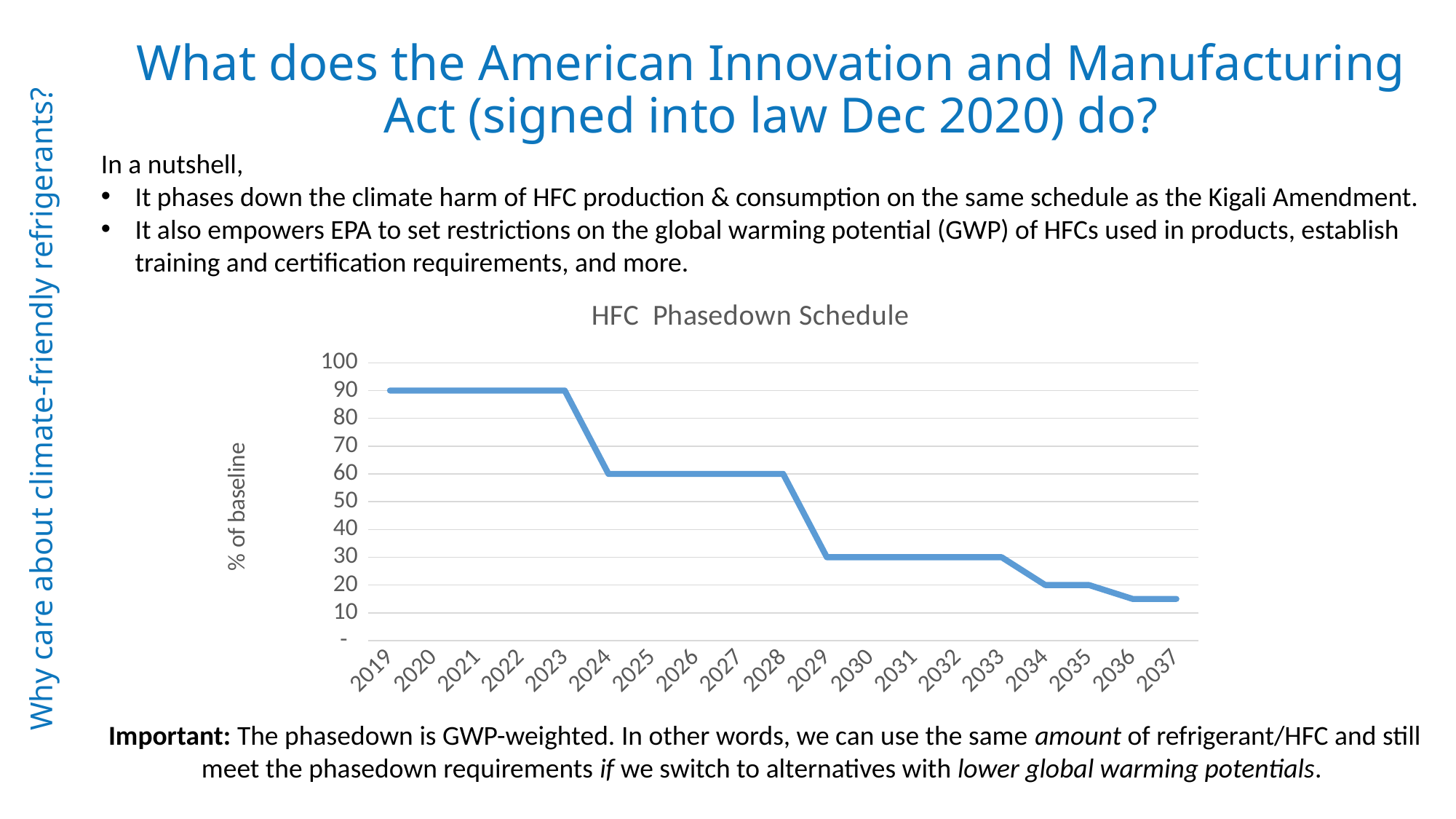
What is the difference between the value for 2019 and the value for 2033? 60 Is the value for 2037 greater or less than 20? less What is the label on the vertical axis of the chart? % of baseline What type of chart is shown on the slide? Line chart What is the value for 2029 in the HFC Phasedown Schedule chart? 30 What is the value for 2034 in the HFC Phasedown Schedule chart? 20 Which year has the larger value, 2028 or 2029? 2028 What is the title of the chart? HFC Phasedown Schedule How many years are shown on the x axis of the chart? 19 What is the value for 2019 in the HFC Phasedown Schedule chart? 90 What is the difference between the value for 2023 and the value for 2024? 30 What is the value for 2024 in the HFC Phasedown Schedule chart? 60